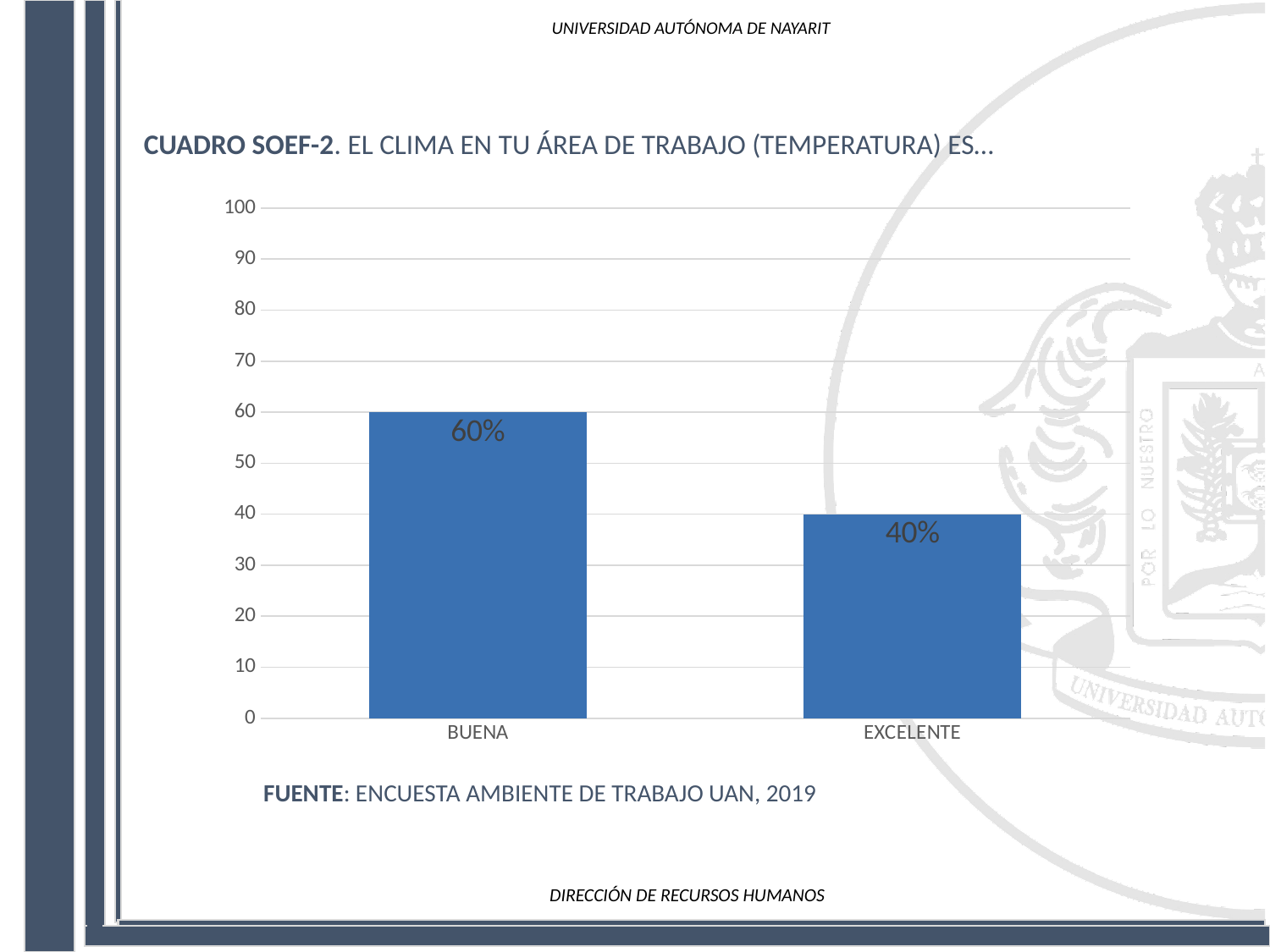
Which category has the lowest value? EXCELENTE What is the difference between the values for BUENA and EXCELENTE? 20% What source is cited below the chart? ENCUESTA AMBIENTE DE TRABAJO UAN, 2019 Is the value for BUENA greater or less than 50? greater Is the value for EXCELENTE greater or less than 50? less How many categories are shown on the x axis? 2 Which is larger, the value for BUENA or the value for EXCELENTE? BUENA What is the value for EXCELENTE? 40% What kind of chart is shown on the slide? bar chart What is the maximum value shown on the vertical axis? 100 What is the value for BUENA? 60% Which category has the highest value? BUENA